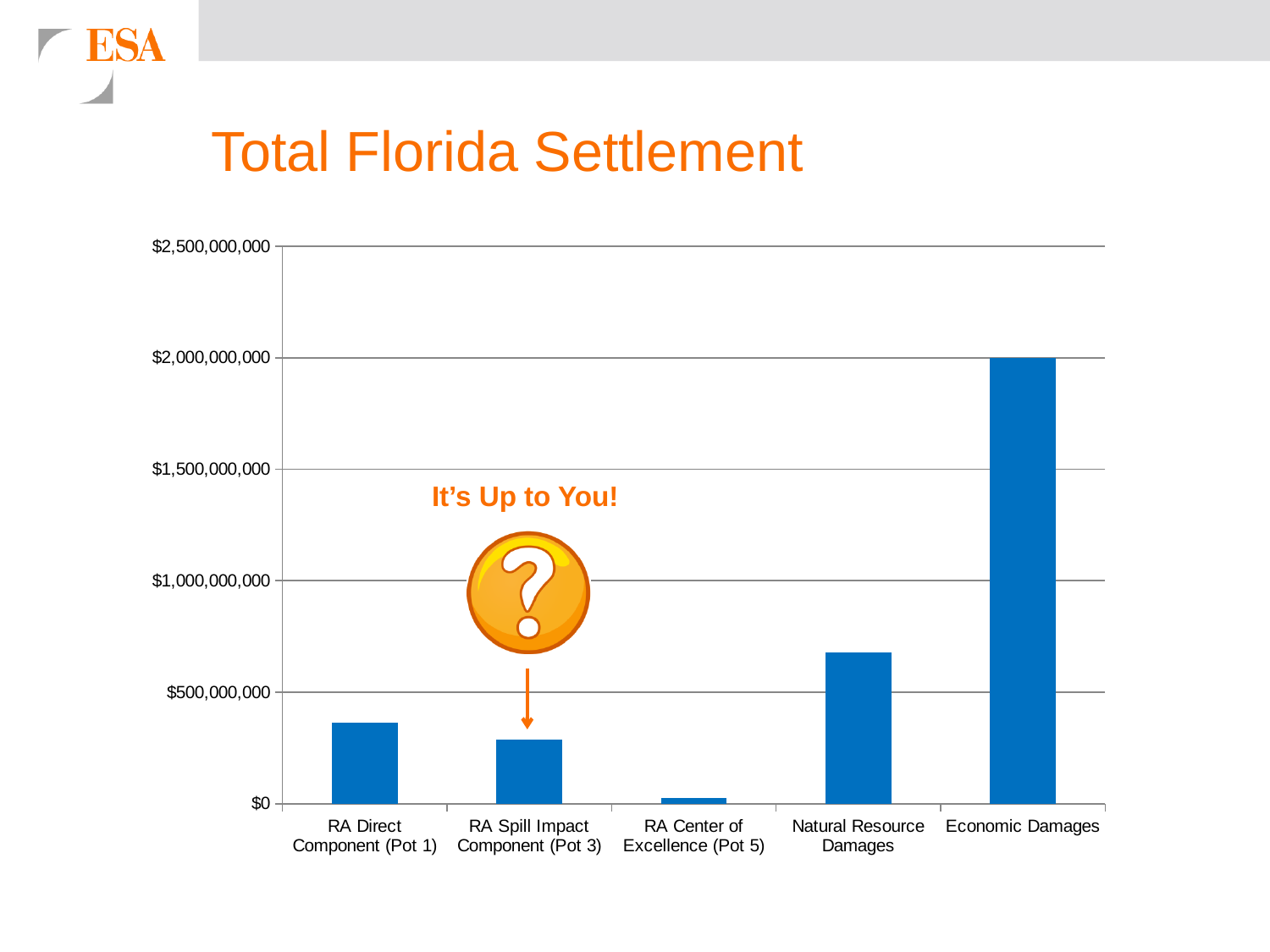
Is the value for Natural Resource Damages greater or less than $1,000,000,000? less Which is larger, the value for Natural Resource Damages or the value for RA Direct Component (Pot 1)? Natural Resource Damages Which category has the lowest value? RA Center of Excellence (Pot 5) How many categories are plotted on the x axis? 5 What is the value for Economic Damages? $2,000,000,000 Which category does the "It's Up to You!" question-mark annotation point to? RA Spill Impact Component (Pot 3) What kind of chart is shown on the slide? Bar chart Is the value for RA Spill Impact Component (Pot 3) greater or less than $500,000,000? less Is the value for RA Direct Component (Pot 1) greater or less than $500,000,000? less Which category has the highest value? Economic Damages What is the title of the chart? Total Florida Settlement